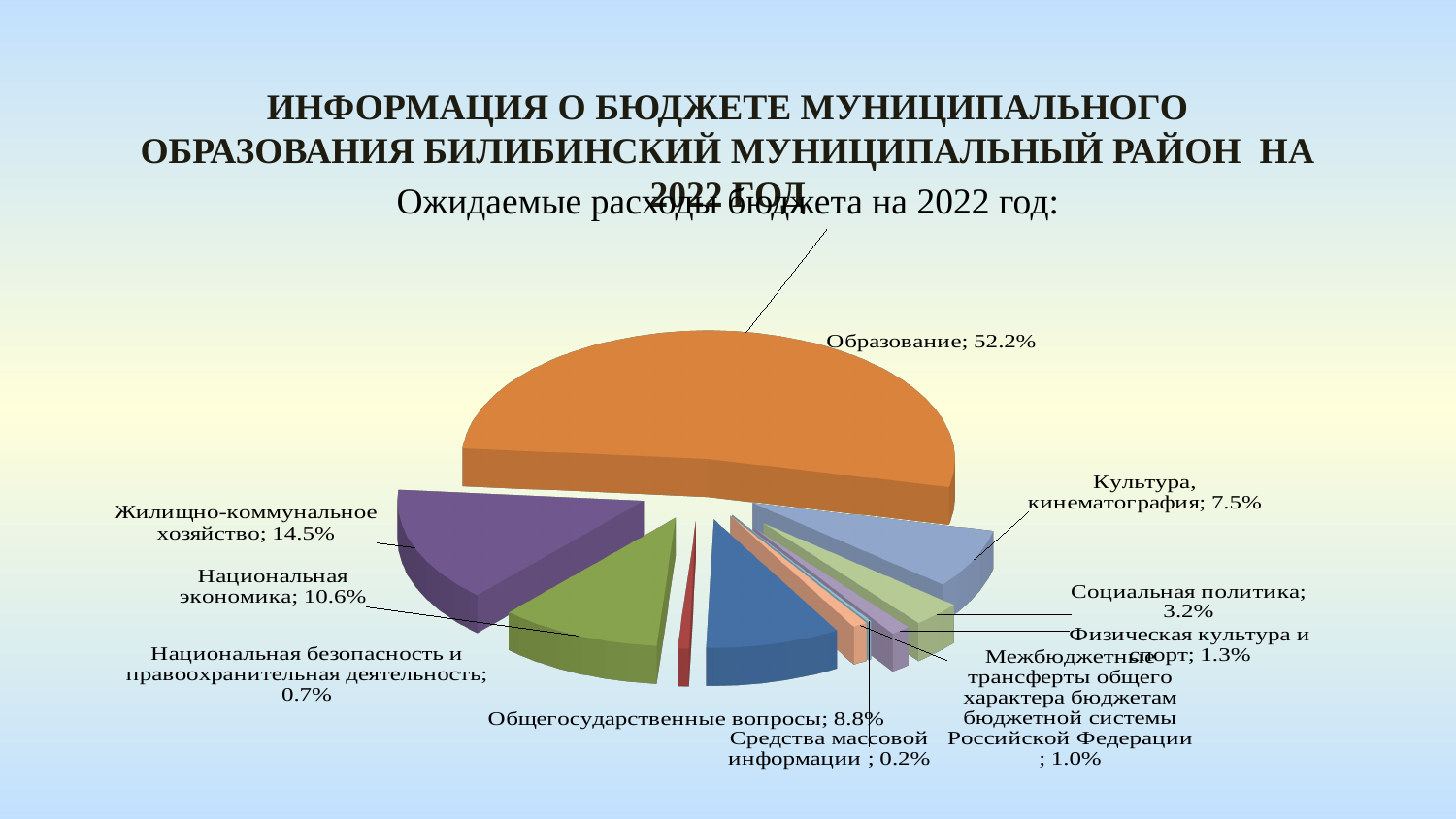
What share is shown for Культура, кинематография? 7.5% What is the value for Общегосударственные вопросы? 8.8% What is the value shown for Жилищно-коммунальное хозяйство? 14.5% What percentage is labelled for Национальная экономика? 10.6% Which category has the smallest share of the pie? Средства массовой информации What type of chart is shown on the slide? pie chart Which is larger: the share for Социальная политика or the share for Физическая культура и спорт? Социальная политика What share of expected 2022 budget expenditures goes to Образование? 52.2% What is the value for Средства массовой информации? 0.2% Which category has the largest share of the pie? Образование What is the difference between the shares of Жилищно-коммунальное хозяйство and Национальная экономика? 3.9% How many categories (slices) does the pie chart contain? 10